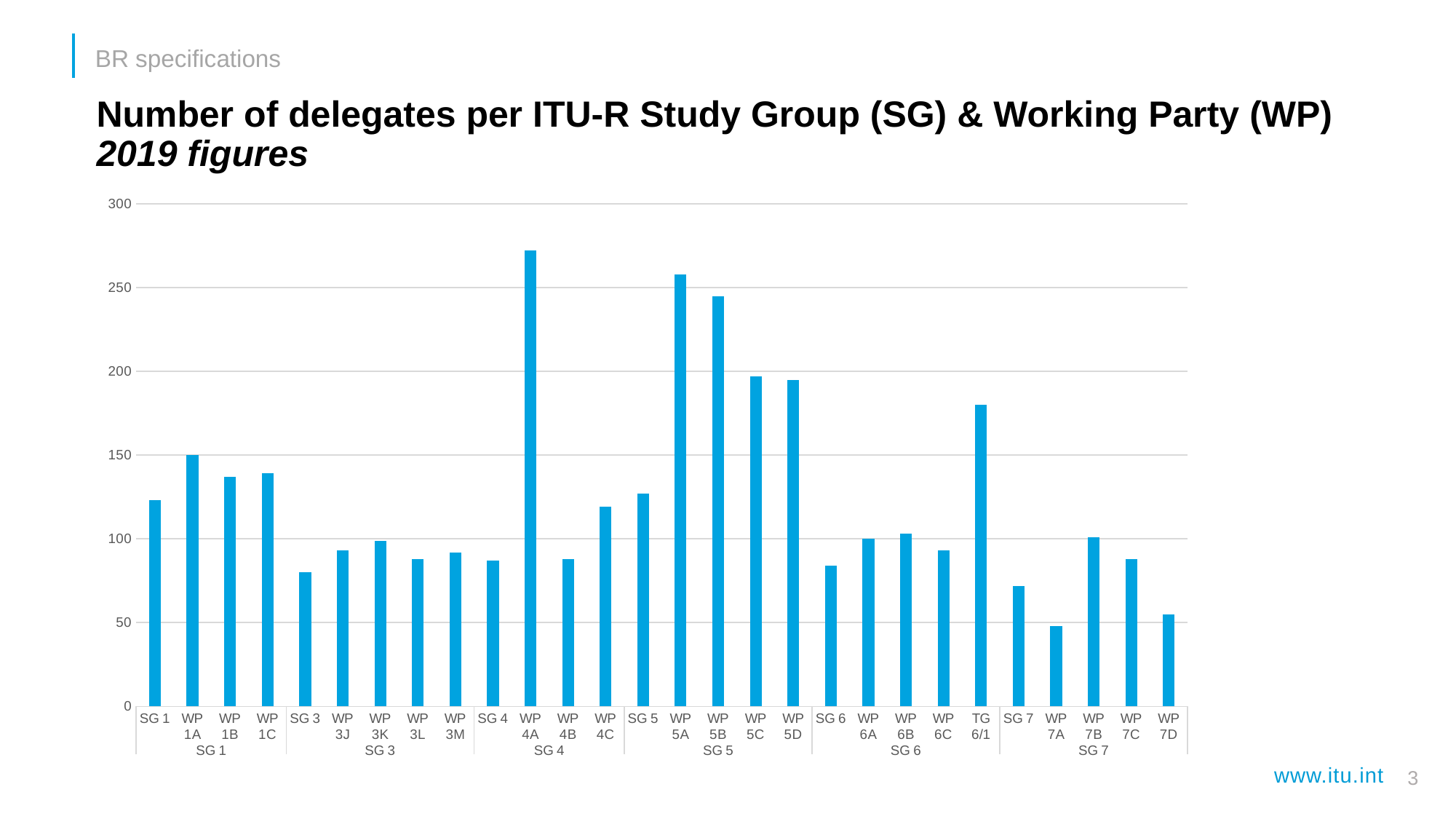
How many Study Group sections are labelled along the x axis? 6 Which has more delegates, TG 6/1 or SG 6? TG 6/1 Which has more delegates, WP 7B or WP 7A? WP 7B What kind of chart is shown on the slide? bar chart Is the value for SG 3 greater or less than 100? less Is the value for TG 6/1 greater or less than 150? greater Which category has the lowest number of delegates? WP 7A How many bars are plotted in the chart? 28 Is the value for WP 4A greater or less than 250? greater Which category has the highest number of delegates? WP 4A